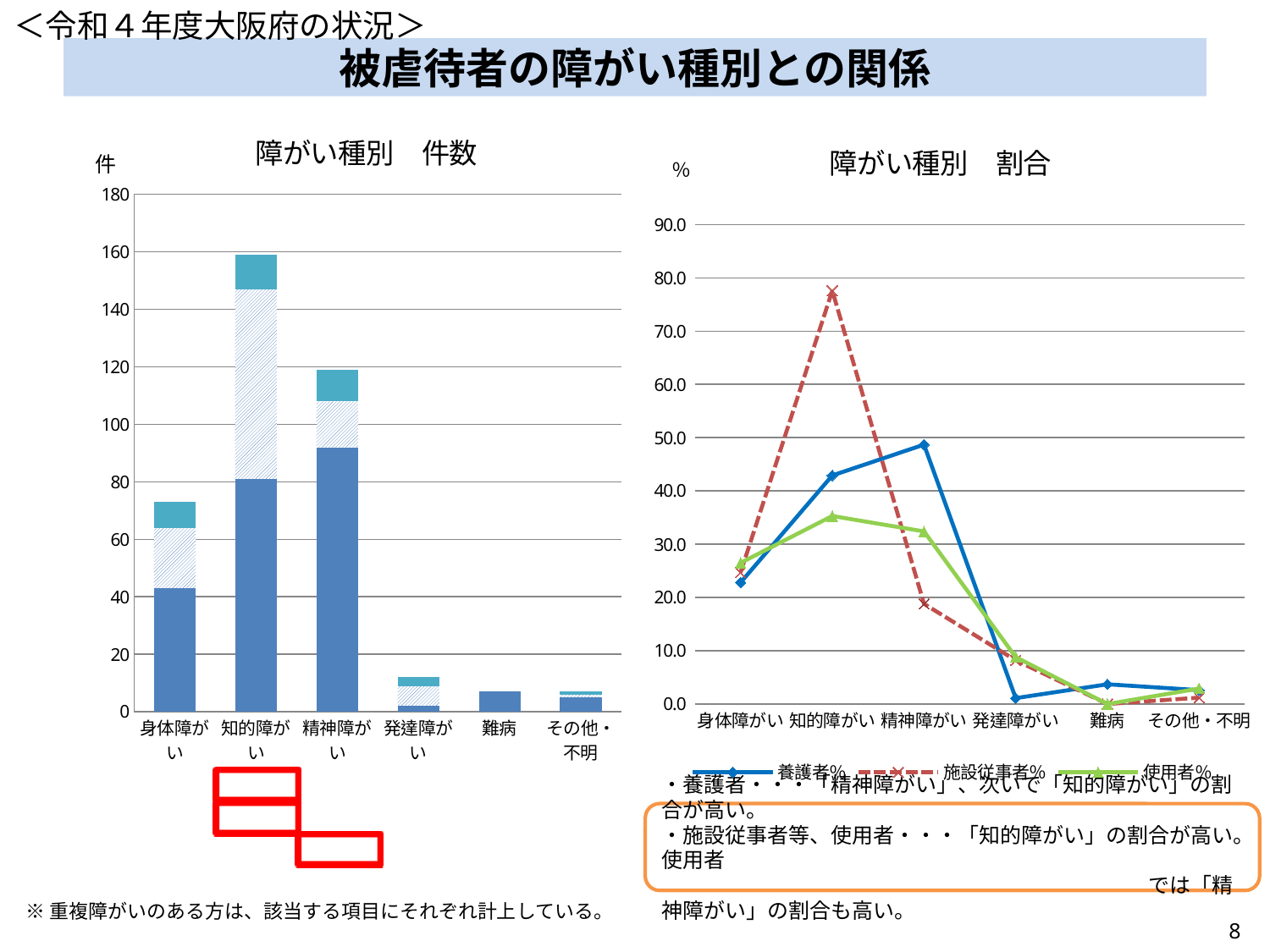
In the right chart (障がい種別 割合), at which category does the 養護者% series reach its highest value? 精神障がい In the left chart (障がい種別 件数), is the total for 発達障がい greater or less than 20? less In the right chart (障がい種別 割合), how many series does the legend list? 3 In the left chart (障がい種別 件数), is the total for 身体障がい greater or less than 80? less In the left chart (障がい種別 件数), how many categories are shown on the x axis? 6 What kind of chart is the right chart titled 障がい種別 割合? line chart In the left chart (障がい種別 件数), is the total for 知的障がい greater or less than 140? greater In the left chart (障がい種別 件数), which category has the tallest stacked bar? 知的障がい In the right chart (障がい種別 割合), at which category does the 施設従事者% series reach its highest value? 知的障がい In the right chart (障がい種別 割合), which series has the larger value at 精神障がい: 養護者% or 施設従事者%? 養護者% What kind of chart is the left chart titled 障がい種別 件数? bar chart